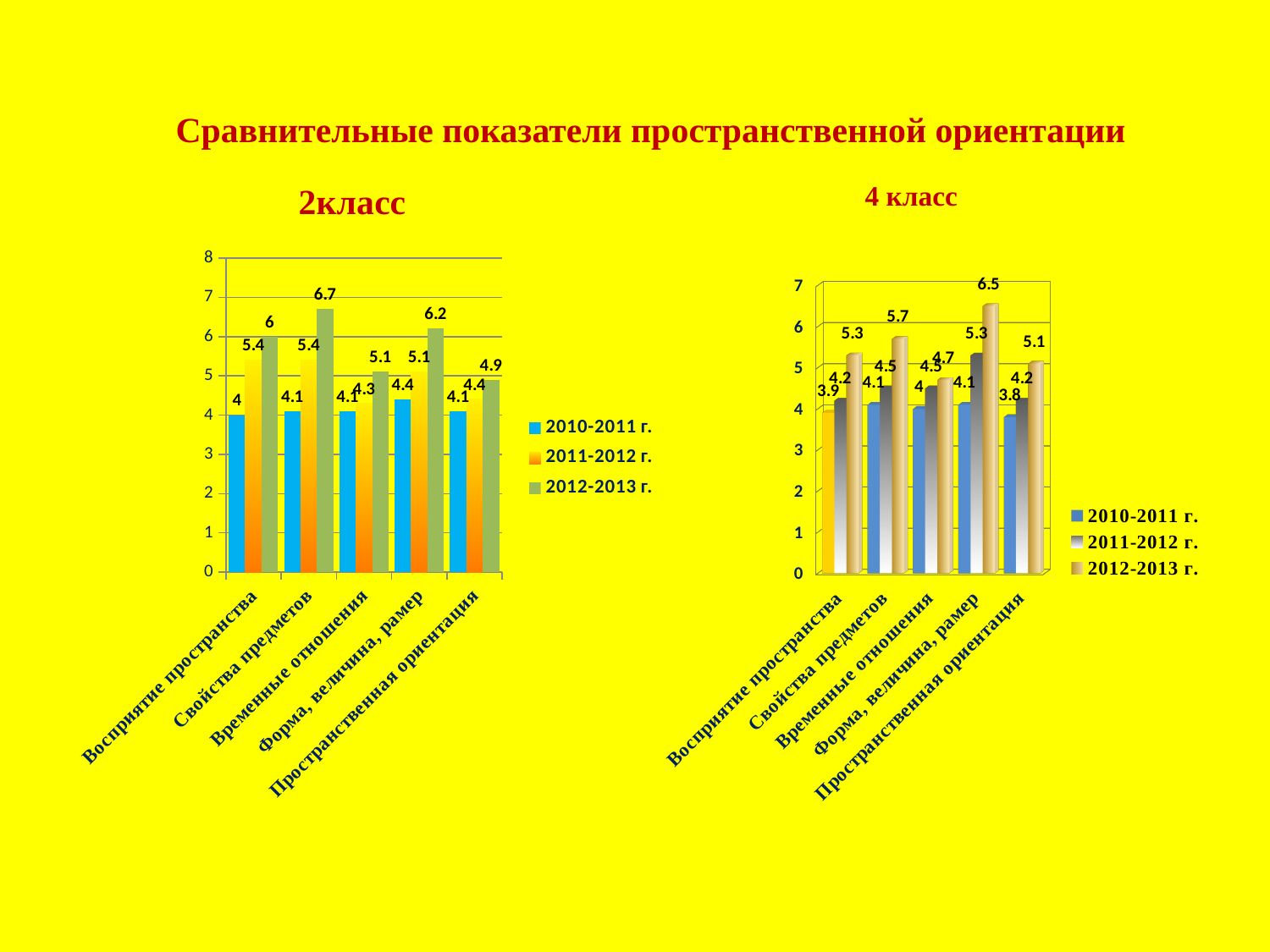
On the 4 класс chart, which category has the lowest value in the 2010-2011 г. series? Пространственная ориентация On the 2класс chart, which category has the highest value in the 2012-2013 г. series? Свойства предметов On the 2класс chart, what is the value for Свойства предметов in 2012-2013 г.? 6.7 On the 4 класс chart, which is larger: the 2012-2013 г. value for Свойства предметов or for Временные отношения? Свойства предметов On the 2класс chart, what is the value for Восприятие пространства in 2010-2011 г.? 4 How many categories are shown on the 2класс chart? 5 On the 4 класс chart, what is the value for Форма, величина, рамер in 2012-2013 г.? 6.5 On the 4 класс chart, what is the value for Пространственная ориентация in 2010-2011 г.? 3.8 What kind of chart is the 4 класс chart? Bar chart On the 2класс chart, which category has the lowest value in the 2012-2013 г. series? Пространственная ориентация How many series does the legend of the 4 класс chart list? 3 On the 2класс chart, what is the difference between the 2012-2013 г. and 2010-2011 г. values for Форма, величина, рамер? 1.8